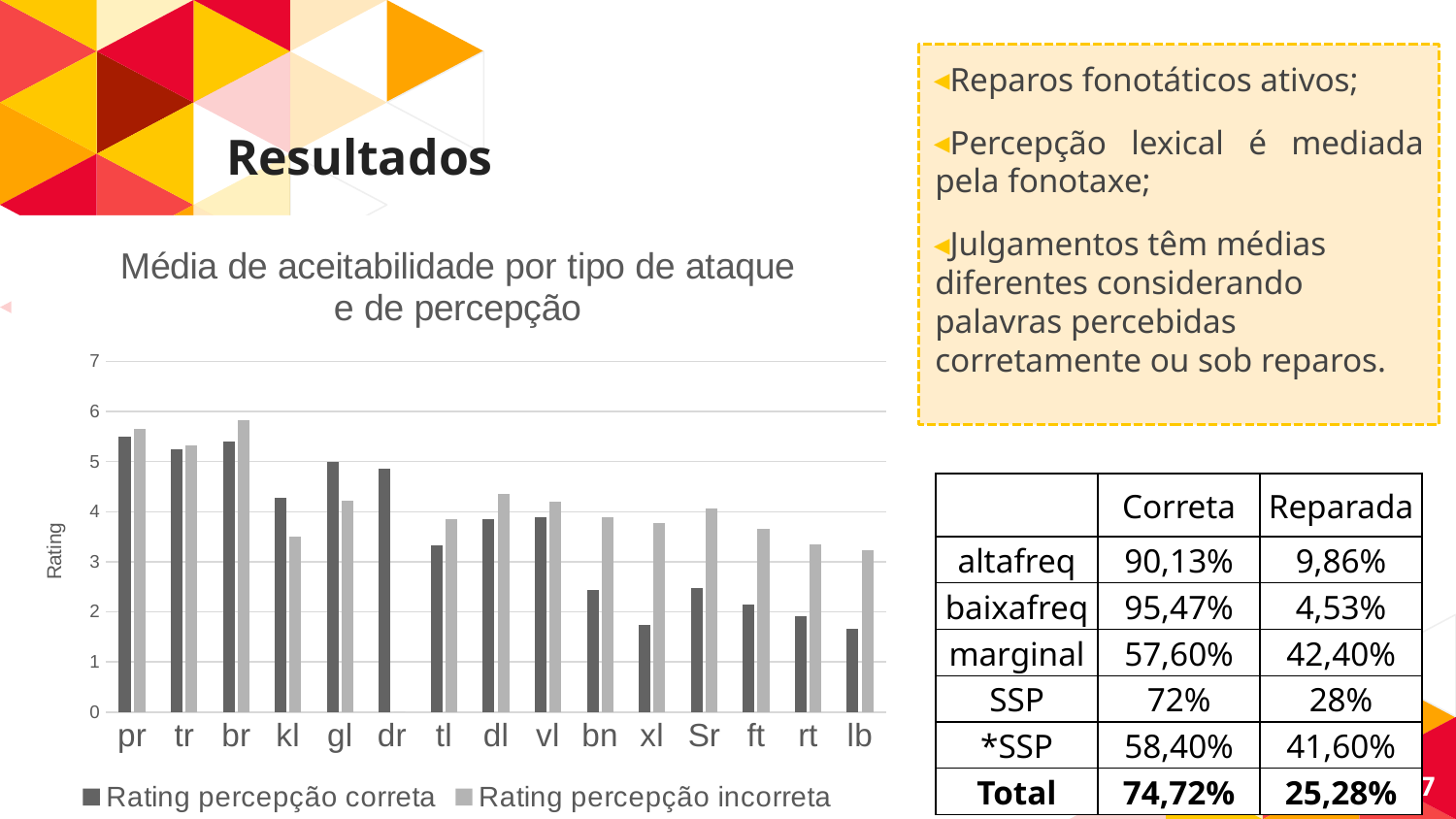
For kl, which is larger: Rating percepção correta or Rating percepção incorreta? Rating percepção correta What is the label of the vertical axis of the chart? Rating Do the values of Rating percepção correta generally rise or fall from pr to lb along the x axis? fall Is the value of Rating percepção incorreta for br greater or less than 5? greater Is the value of Rating percepção incorreta for kl greater or less than 4? less How many series does the chart's legend list? 2 For xl, which is larger: Rating percepção correta or Rating percepção incorreta? Rating percepção incorreta Is the value of Rating percepção correta for pr greater or less than 5? greater How many categories are shown on the x axis of the chart? 15 What is the title of the chart? Média de aceitabilidade por tipo de ataque e de percepção What kind of chart is shown on the slide? bar chart